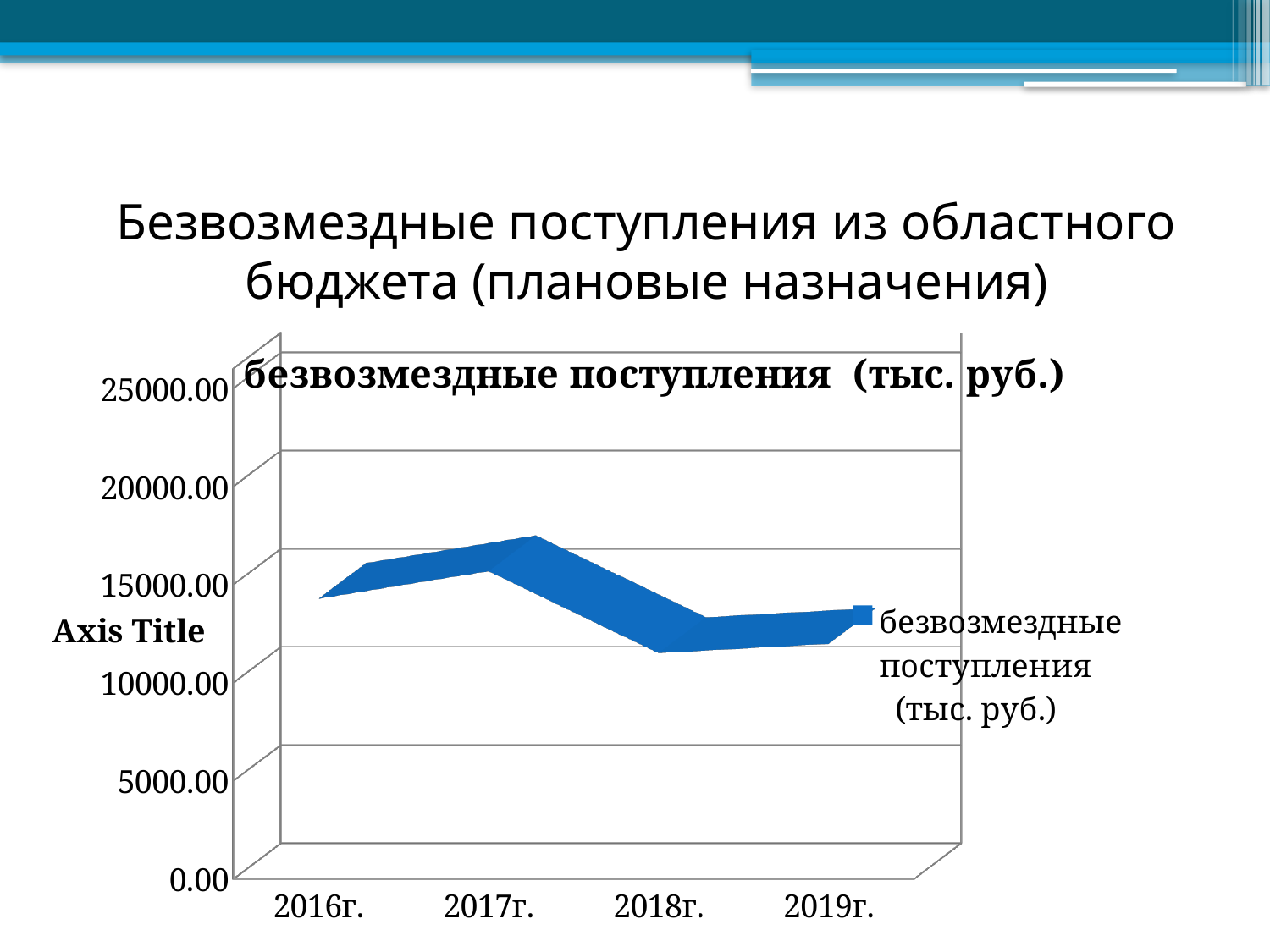
Is the value for 2019г. greater or less than 15000.00? less Which is larger, the value for 2017г. or the value for 2018г.? 2017г. Is the value for 2017г. greater or less than 15000.00? greater Which year has the highest value for безвозмездные поступления? 2017г. Is the value for 2018г. greater or less than 10000.00? greater What is the title printed inside the chart area? безвозмездные поступления (тыс. руб.) Which year has the lowest value for безвозмездные поступления? 2018г. What kind of chart is shown on the slide? line chart How many series does the chart legend list? 1 Does the value rise or fall from 2017г. to 2018г.? fall How many years are plotted along the x axis of the chart? 4